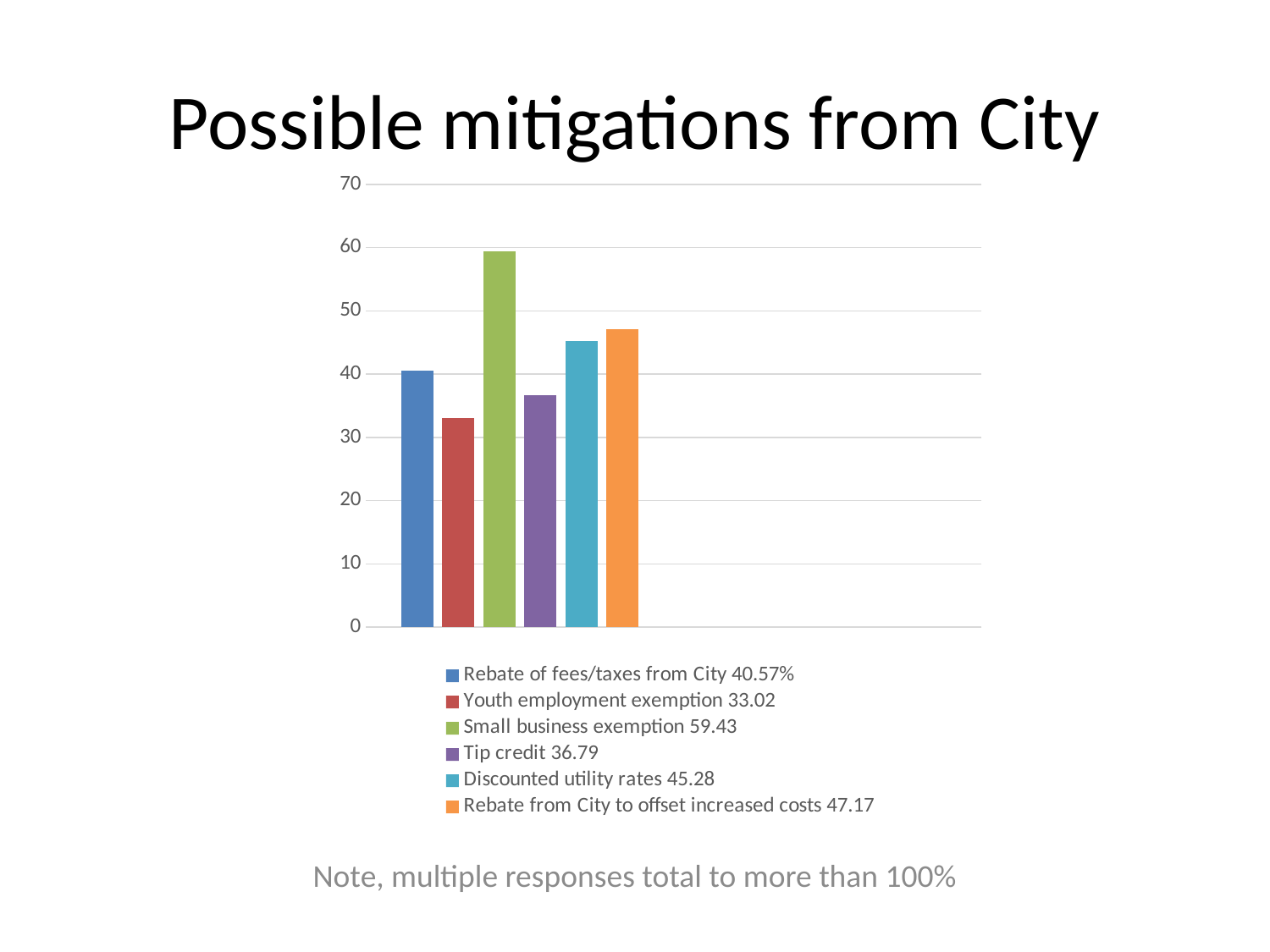
Is the value for Tip credit greater or less than 40? less How many series does the legend list? 6 Which mitigation has the lowest value? Youth employment exemption What is the difference between Small business exemption (59.43) and Youth employment exemption (33.02)? 26.41 What kind of chart is shown on the slide? Bar chart What value does the legend give for Tip credit? 36.79 Which is larger, Discounted utility rates or Rebate from City to offset increased costs? Rebate from City to offset increased costs What value does the legend give for Rebate of fees/taxes from City? 40.57% What value does the legend give for Discounted utility rates? 45.28 Which mitigation has the highest value? Small business exemption What is the title of the slide containing the chart? Possible mitigations from City What value does the legend give for Small business exemption? 59.43